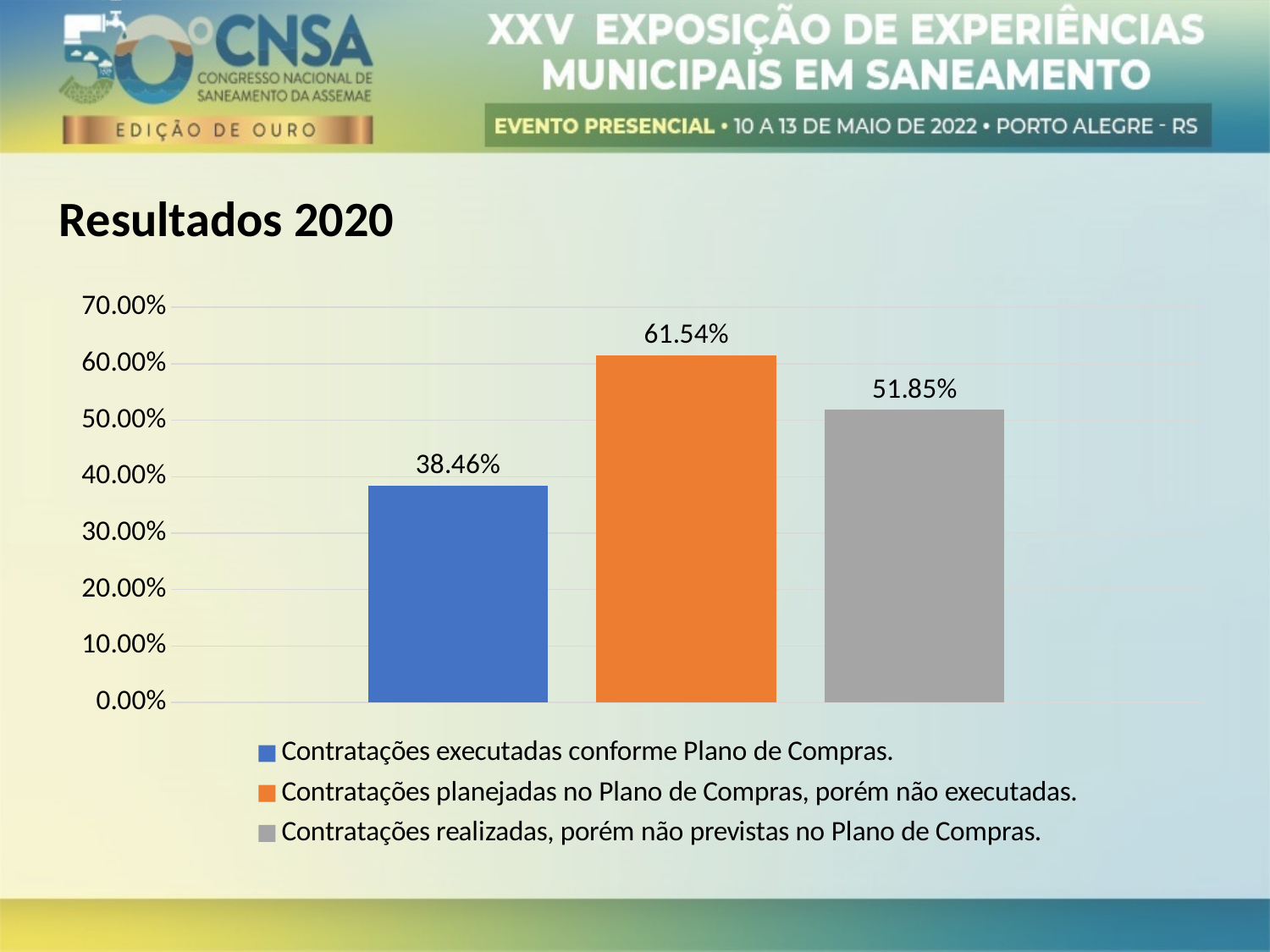
Which category has the highest value? Contratações planejadas no Plano de Compras, porém não executadas. What is the difference between the values for "Contratações planejadas no Plano de Compras, porém não executadas" and "Contratações realizadas, porém não previstas no Plano de Compras"? 9.69% What is the value for "Contratações executadas conforme Plano de Compras"? 38.46% Which category has the lowest value? Contratações executadas conforme Plano de Compras. Is the value for "Contratações executadas conforme Plano de Compras" greater or less than 40.00%? less What colour is the bar for "Contratações planejadas no Plano de Compras, porém não executadas"? orange Which is larger: the value for "Contratações realizadas, porém não previstas no Plano de Compras" or the value for "Contratações executadas conforme Plano de Compras"? Contratações realizadas, porém não previstas no Plano de Compras. What kind of chart is shown on the slide? bar chart What is the difference between the values for "Contratações planejadas no Plano de Compras, porém não executadas" and "Contratações executadas conforme Plano de Compras"? 23.08% How many bars are shown in the chart? 3 What is the value for "Contratações realizadas, porém não previstas no Plano de Compras"? 51.85% What is the value for "Contratações planejadas no Plano de Compras, porém não executadas"? 61.54%